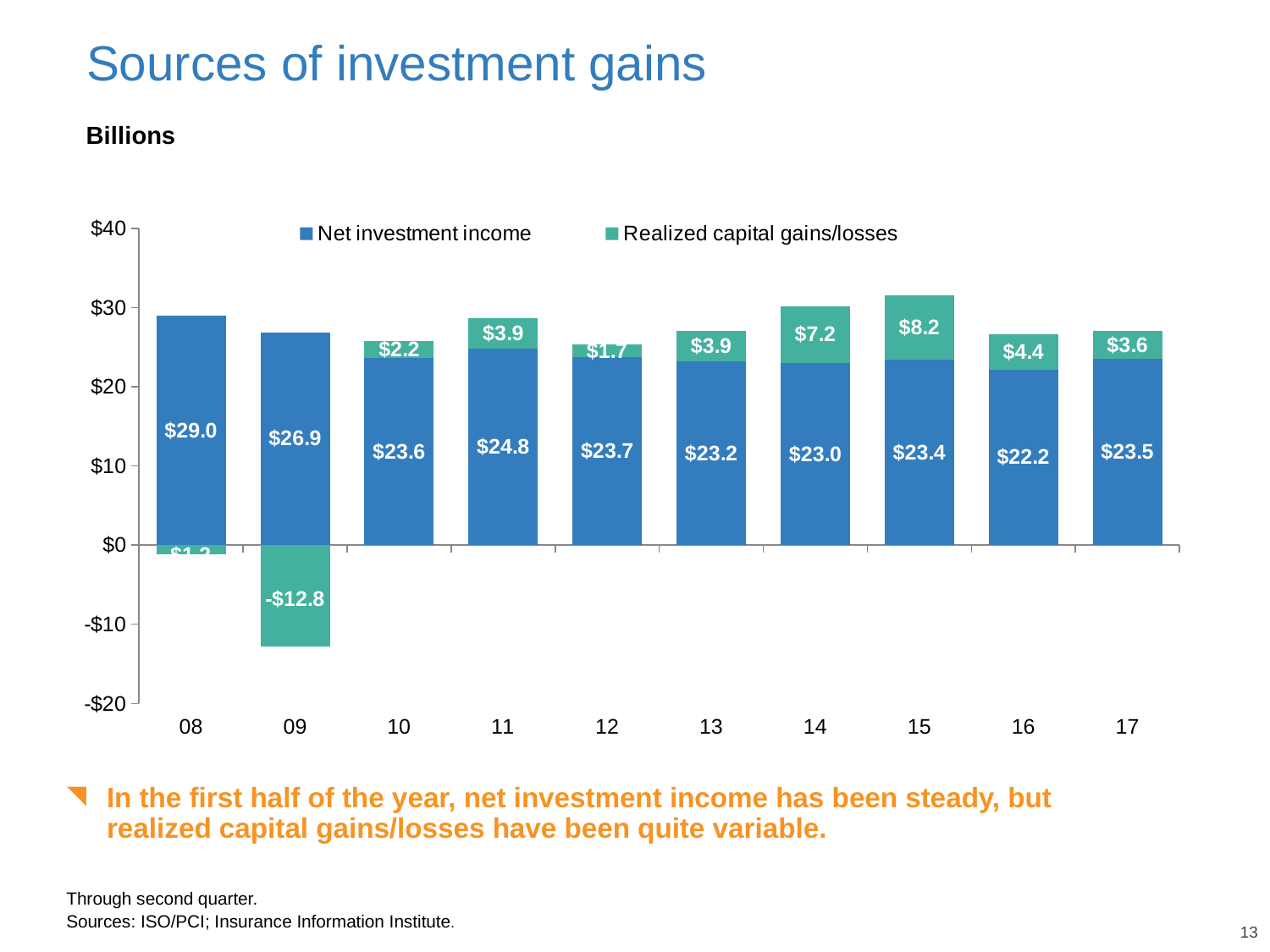
How many years are shown on the x axis? 10 How many series does the legend list? 2 What is the difference between net investment income in 08 and in 16? $6.8 What is the value of realized capital gains/losses for 15? $8.2 What kind of chart is shown on the slide? bar chart What colour represents realized capital gains/losses in the chart? green What is the value of realized capital gains/losses for 09? -$12.8 Which year has larger realized capital gains/losses, 14 or 15? 15 Which year has the highest net investment income? 08 Which year has the lowest net investment income? 16 What is the total of the stacked bar for 15 (net investment income plus realized capital gains/losses)? $31.6 What is the net investment income for 08? $29.0